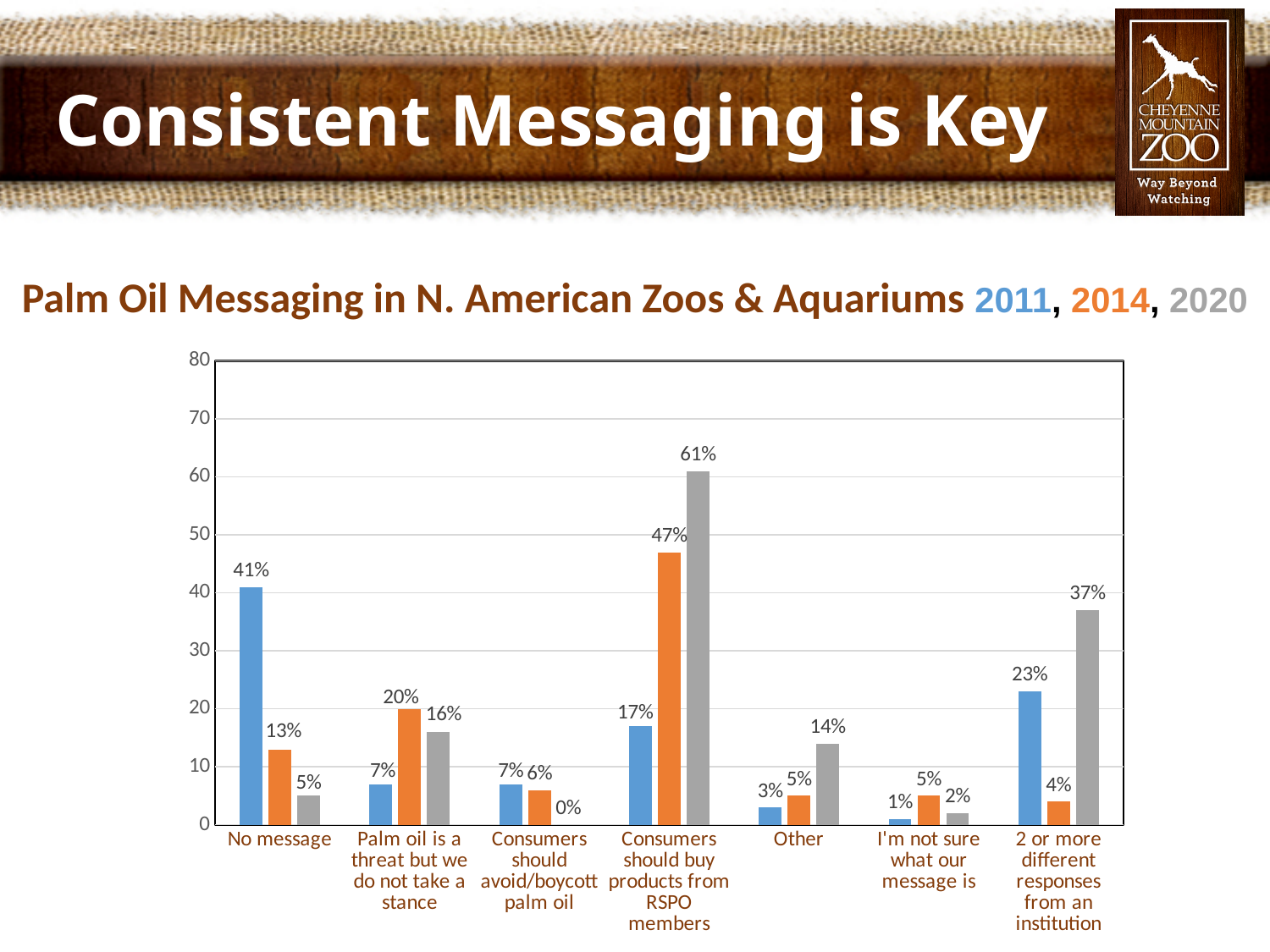
What is the difference between the 2020 and 2011 values for "2 or more different responses from an institution"? 14% For "No message", which year has the larger value, 2011 or 2014? 2011 Which colour represents the 2014 series? Orange What is the 2011 value for "No message"? 41% What is the 2014 value for "Palm oil is a threat but we do not take a stance"? 20% How many categories are shown on the x axis? 7 What is the 2020 value for "Consumers should buy products from RSPO members"? 61% Is the 2014 value for "Consumers should buy products from RSPO members" greater or less than 40? greater Which category has the lowest 2011 value? I'm not sure what our message is How many years (series) does the chart compare? 3 Which category has the highest 2020 value? Consumers should buy products from RSPO members What kind of chart is shown on the slide? Bar chart